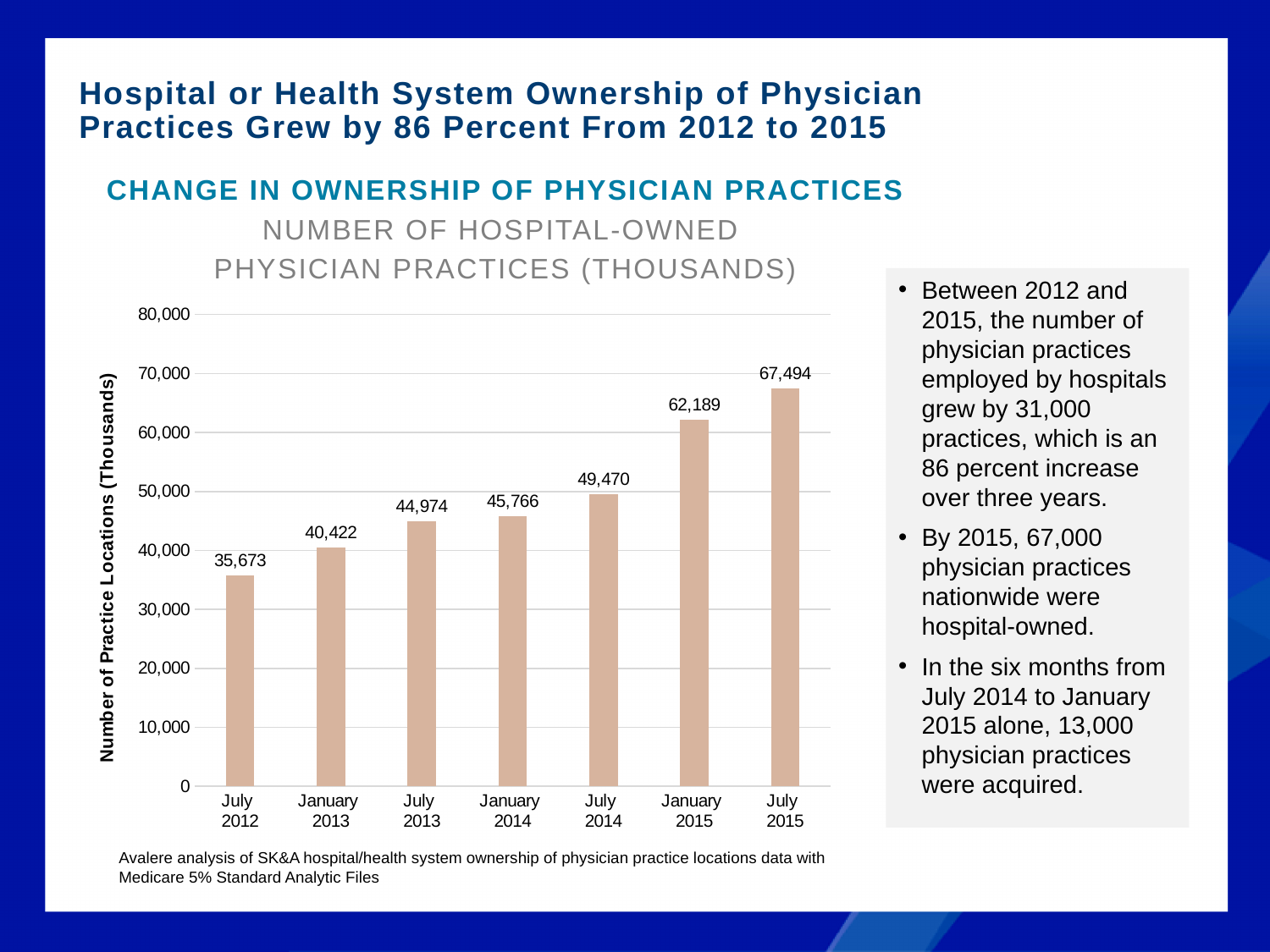
Do the values rise or fall from July 2012 to July 2015? rise Is the value for January 2013 greater or less than 50,000? less Which period has the lowest number of hospital-owned physician practices? July 2012 Which period has the highest number of hospital-owned physician practices? July 2015 What is the difference between the values for July 2015 and July 2012? 31,821 What is the number of hospital-owned physician practices in July 2012? 35,673 What is the value shown for January 2015? 62,189 What kind of chart is shown on the slide? bar chart How many time periods are shown on the x axis? 7 What is the difference between the values for January 2015 and July 2014? 12,719 What is the value shown for July 2014? 49,470 Which is larger, the value for January 2014 or the value for July 2013? January 2014